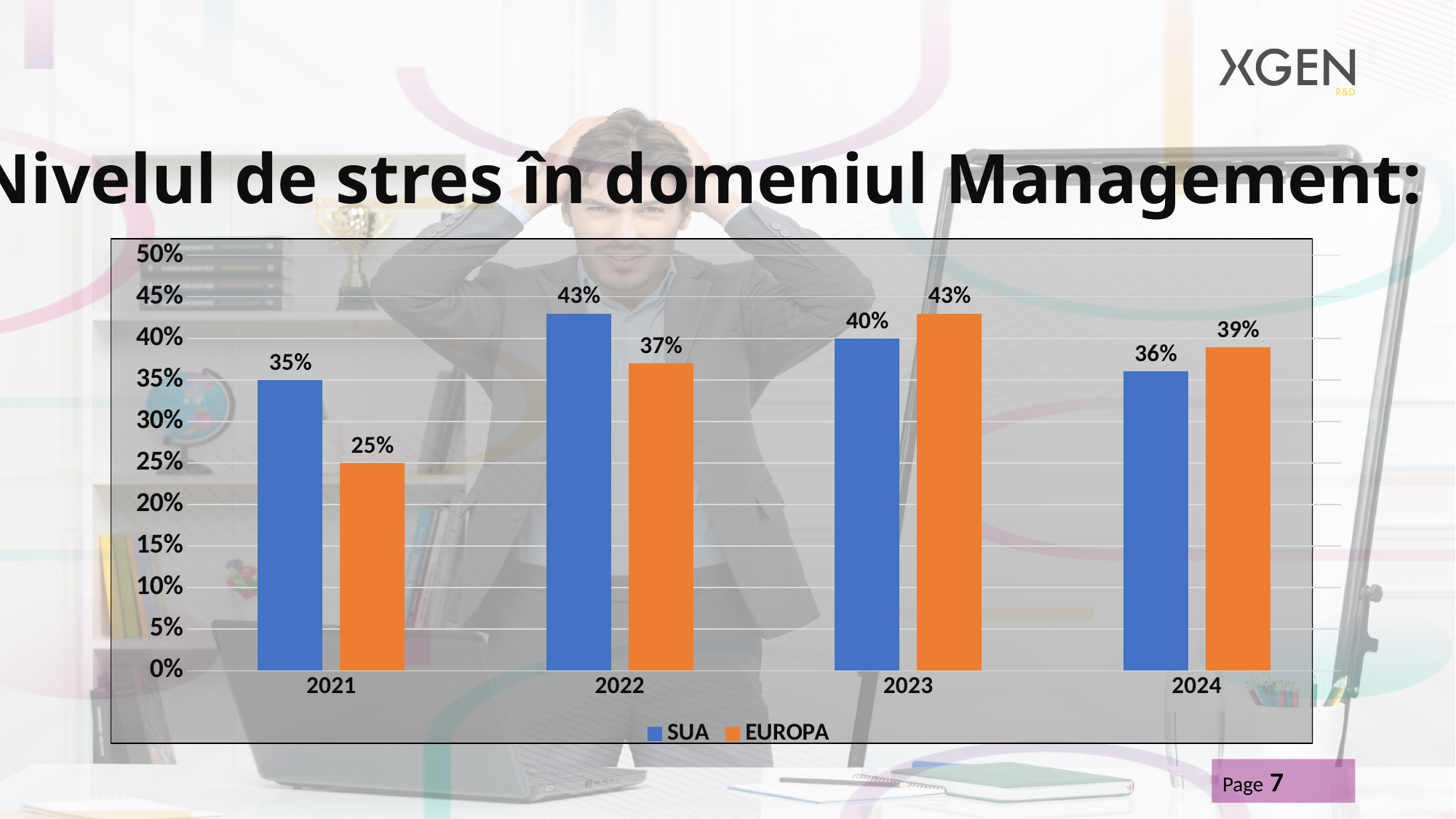
What is the value for EUROPA in 2023? 43% What is the value for EUROPA in 2024? 39% In which year is the EUROPA value lowest? 2021 Which is larger in 2022, SUA or EUROPA? SUA In which year is the SUA value highest? 2022 What is the difference between the SUA and EUROPA values in 2021? 10% What kind of chart is shown on the slide? Bar chart How many years are shown on the x axis? 4 Which colour represents EUROPA in the chart? Orange How many series does the legend list? 2 Which is larger in 2023, SUA or EUROPA? EUROPA What is the value for SUA in 2021? 35%